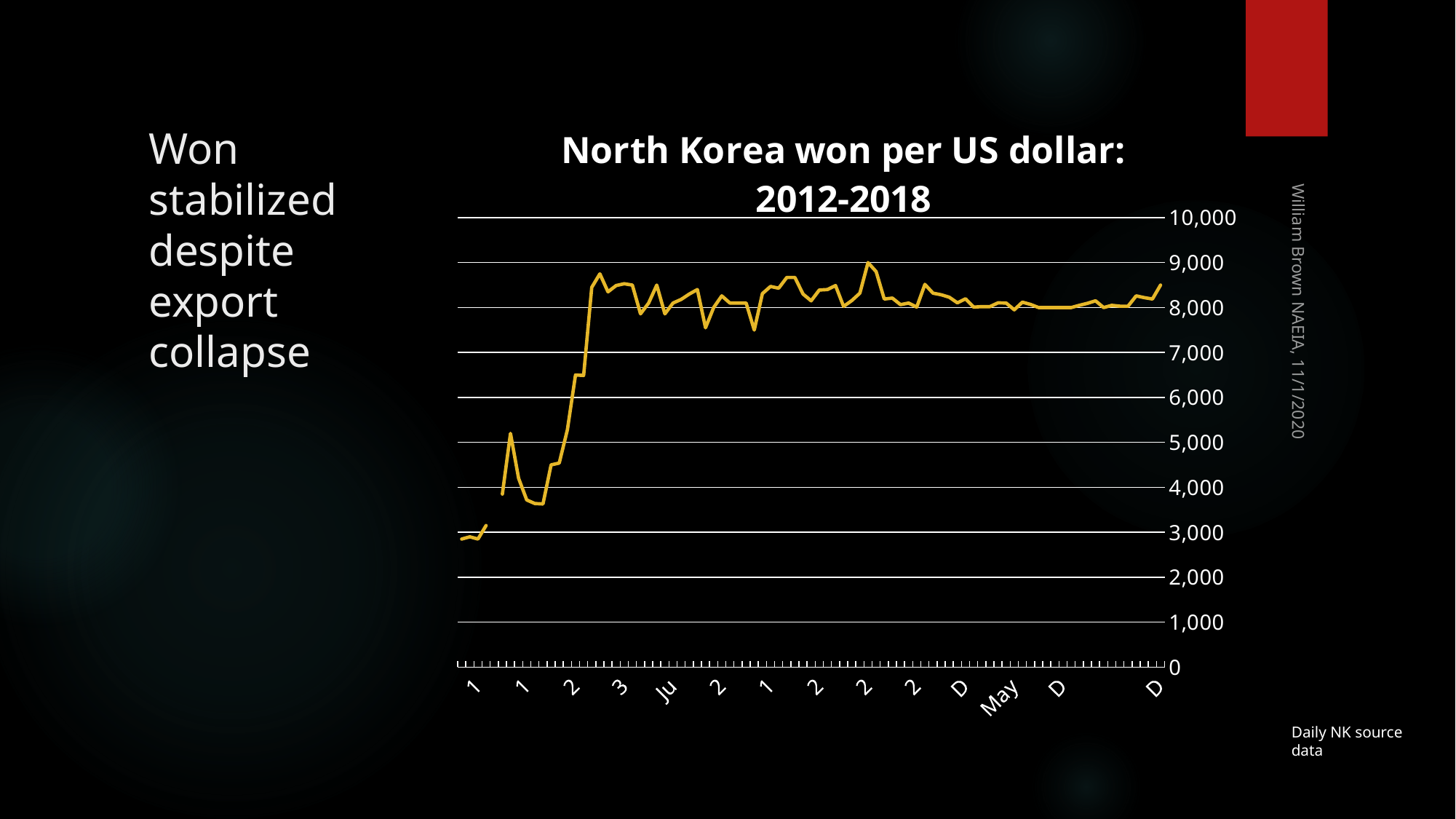
Is the value at the start of the series (left end) greater or less than 4,000? less After the sharp rise in the line, does the series stay mostly above or below 7,000? above Is the value at the end of the series greater or less than 7,000? greater What kind of chart is shown on the slide? Line chart Which is larger: the value at the start of the series or the value at the end of the series? The value at the end How many lines (data series) are plotted on the chart? 1 Overall, does the won-per-dollar line rise or fall from the left end of the x axis to the right end? Rise What is the highest value shown on the vertical axis? 10,000 What is the title of the chart? North Korea won per US dollar: 2012-2018